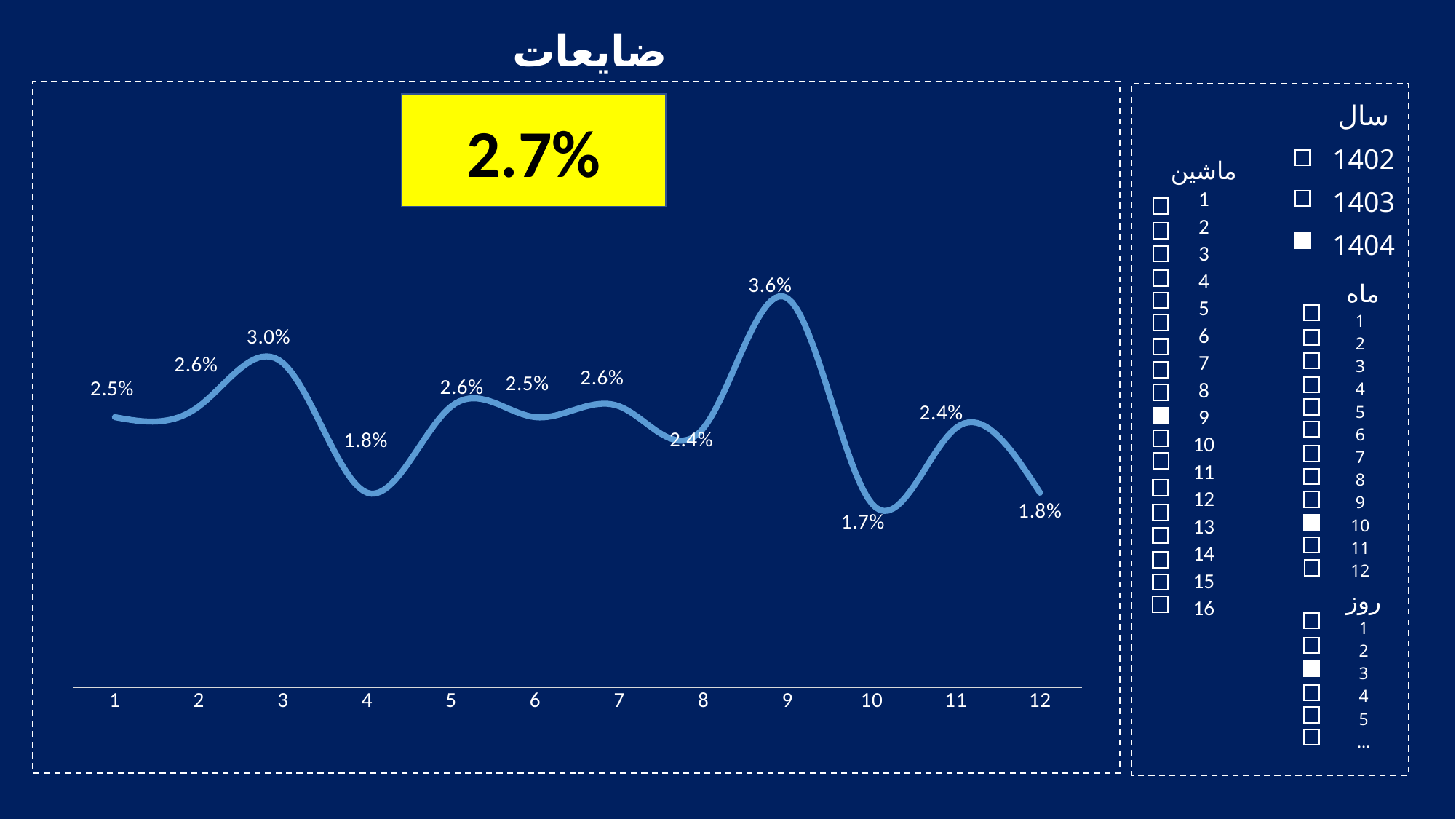
At which x-axis point does the line reach its lowest value? 10 How many data points are plotted on the line chart? 12 What value is shown in the yellow box above the chart? 2.7% What is the value at x = 4 on the line chart? 1.8% What kind of chart is shown on the slide? line chart What is the difference between the value at x = 3 and the value at x = 4? 1.2% What is the difference between the value at x = 9 and the value at x = 10? 1.9% What is the value at x = 1 on the line chart? 2.5% Which is larger, the value at x = 3 or the value at x = 11? x = 3 At which x-axis point does the line reach its highest value? 9 What is the value at x = 10 on the line chart? 1.7% What is the value at x = 9 on the line chart? 3.6%